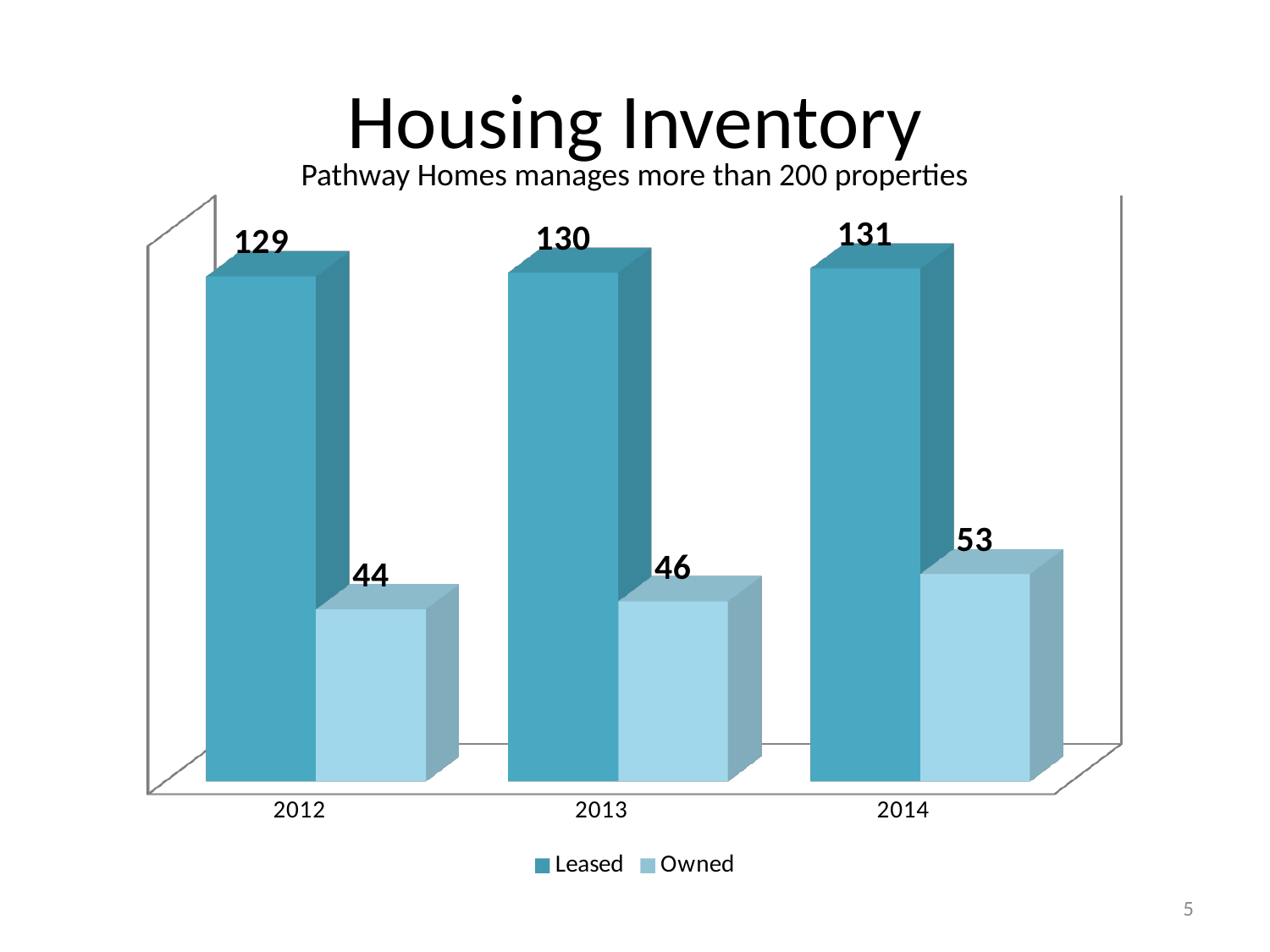
How many years are shown on the x axis? 3 How many series does the legend list? 2 Do the Leased values rise or fall from 2012 to 2014? rise What is the value for Owned in 2013? 46 What is the value for Owned in 2014? 53 In which year is the Owned value highest? 2014 What is the difference between Leased and Owned in 2014? 78 What is the value for Leased in 2012? 129 What kind of chart is shown? bar chart Which is larger in 2013, Leased or Owned? Leased In which year is the Owned value lowest? 2012 What is the difference between the Owned values for 2014 and 2012? 9